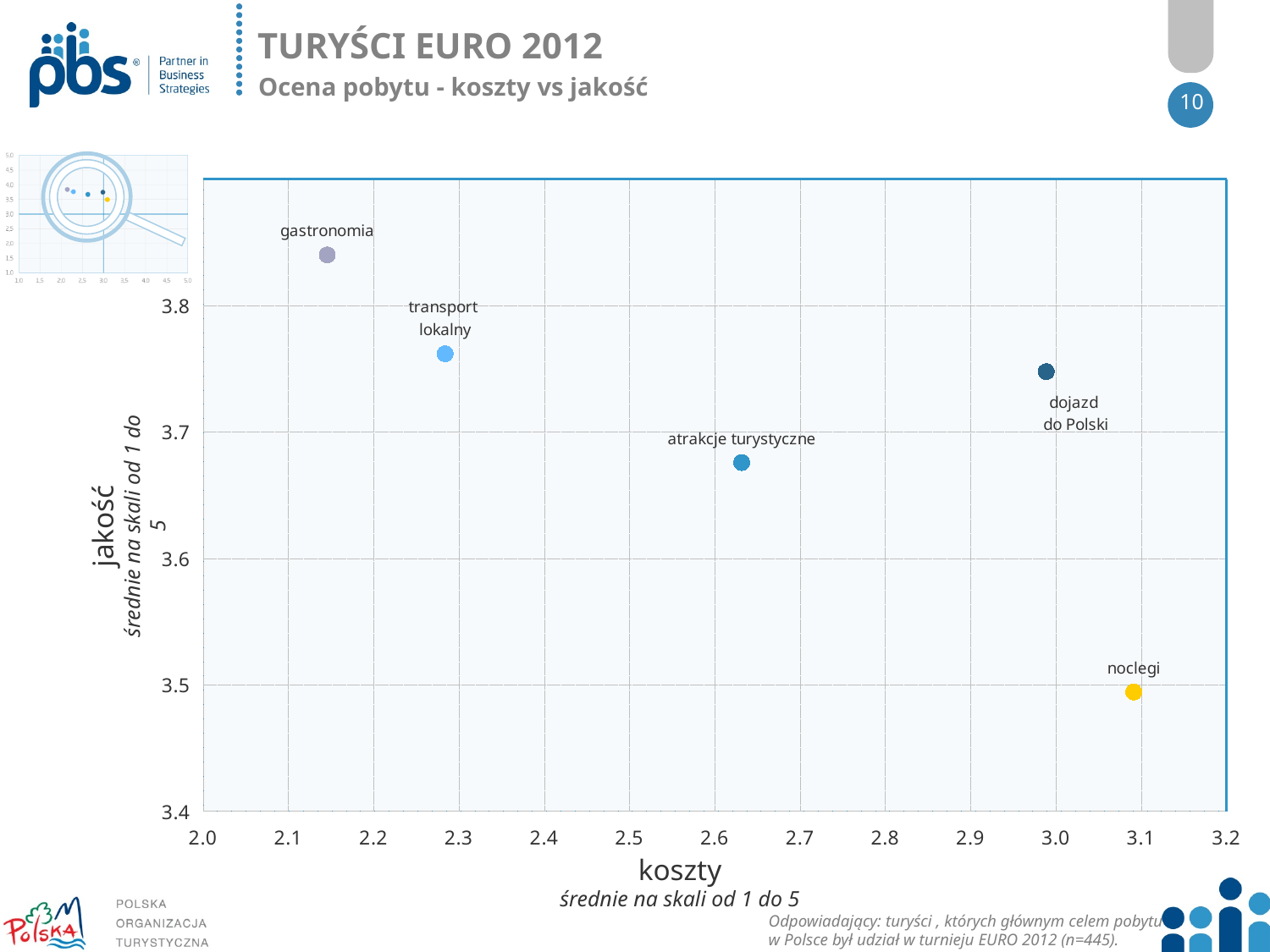
Which category has the highest koszty (cost) value? noclegi Is the koszty value for transport lokalny greater or less than 2.4? less Is the koszty value for noclegi greater or less than 3.0? greater Which category has the lowest koszty (cost) value? gastronomia Which category has the highest jakość (quality) value? gastronomia What is the title of the horizontal axis? koszty Which category has the lowest jakość (quality) value? noclegi How many data points are plotted on the chart? 5 Which has the higher koszty value, atrakcje turystyczne or transport lokalny? atrakcje turystyczne What kind of chart is shown on the slide? scatter chart Is the jakość value for noclegi greater or less than 3.6? less